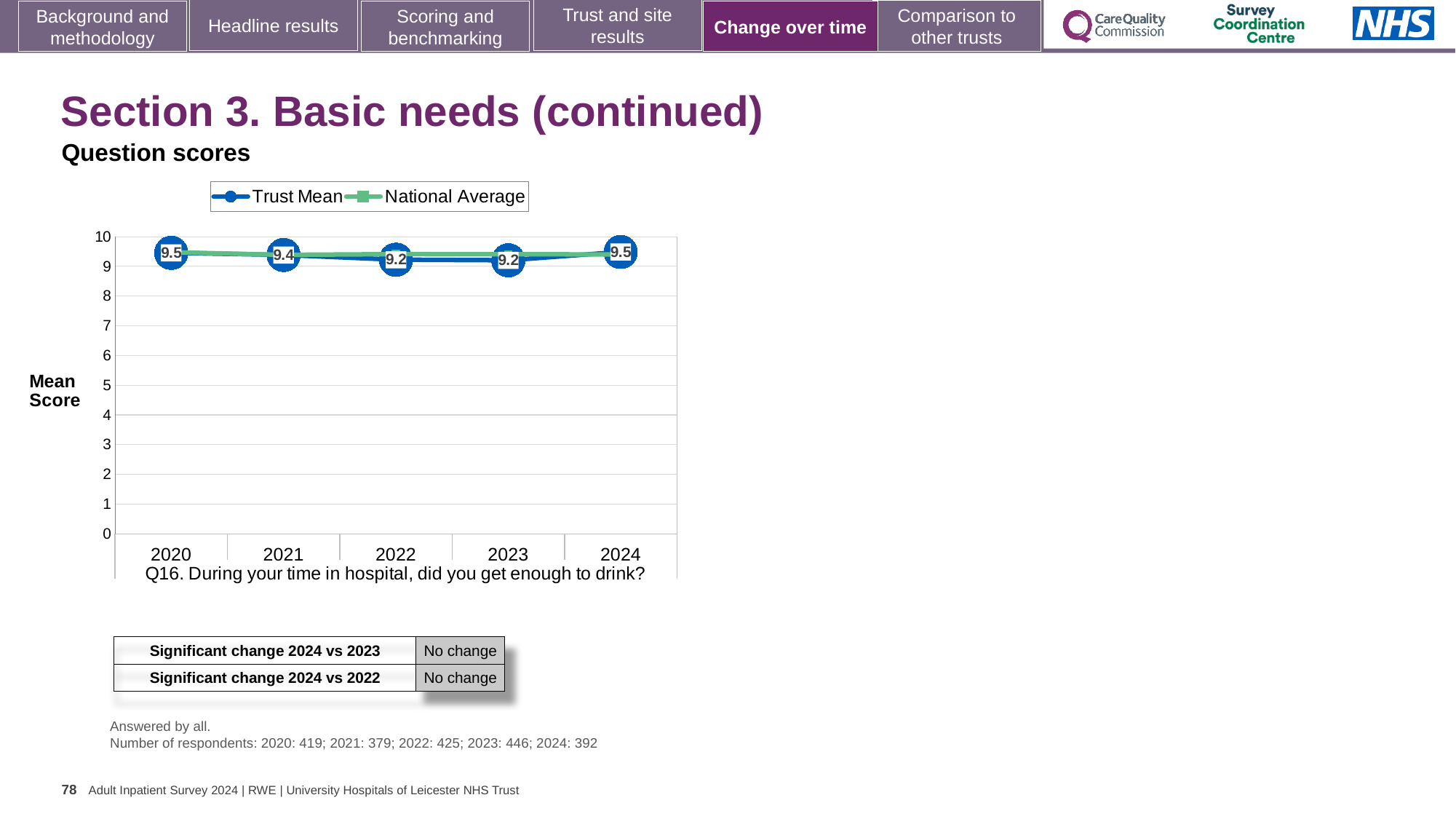
How many years are shown on the x axis of the chart? 5 What is the Trust Mean score for 2020? 9.5 What kind of chart is shown on the slide? Line chart What is the Trust Mean score for 2022? 9.2 What is the difference between the Trust Mean score in 2020 and in 2022? 0.3 Is the National Average value for 2022 greater or less than 9? greater What is the label on the y axis of the chart? Mean Score Which year has the higher Trust Mean score, 2021 or 2023? 2021 What is the Trust Mean score for 2024? 9.5 Does the Trust Mean score rise or fall from 2020 to 2023? Fall What is the Trust Mean score for 2021? 9.4 How many series does the chart legend list? 2